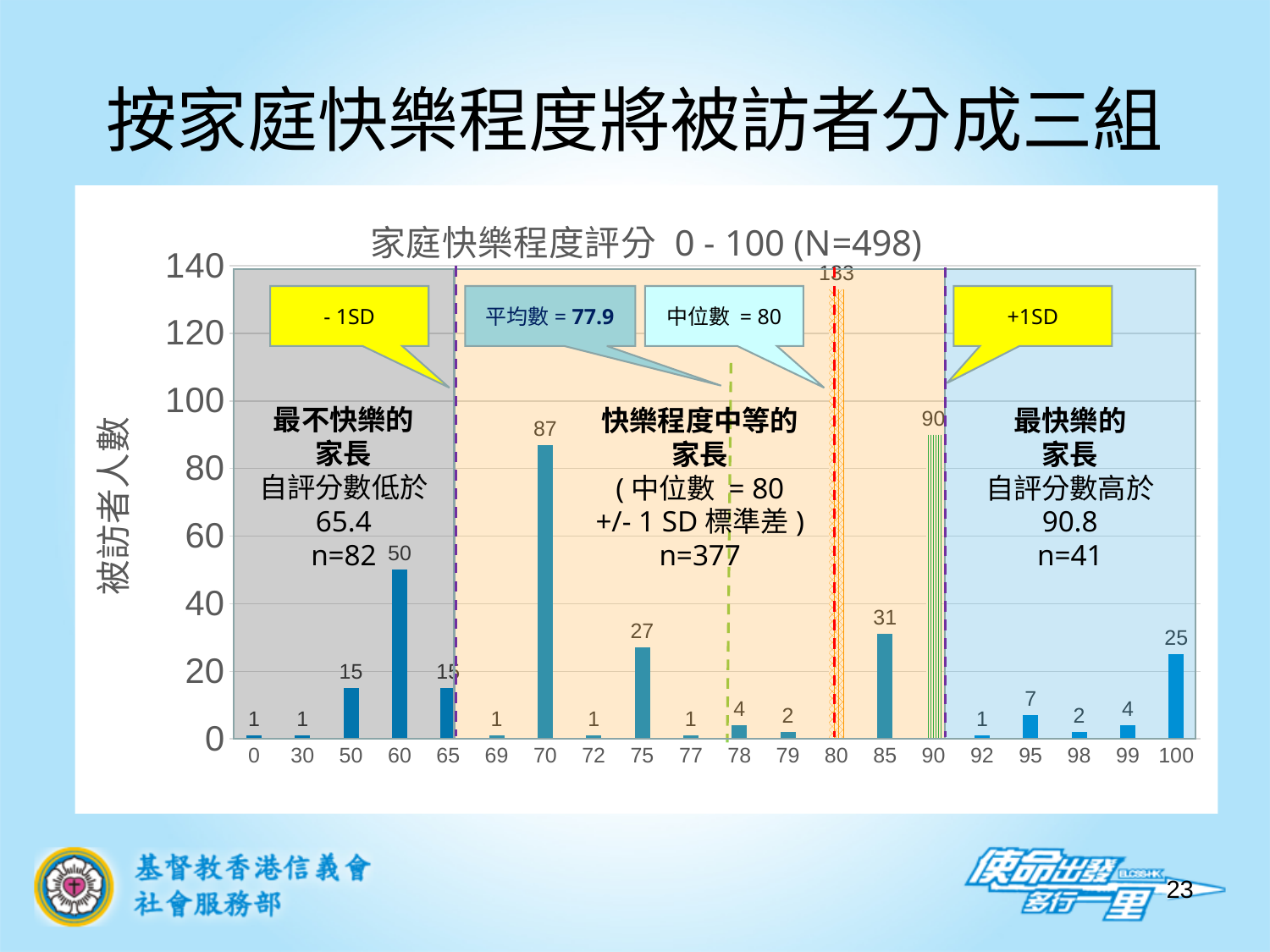
What is the number of respondents for the score of 95? 7 What is the number of respondents for the score of 100? 25 What is the difference between the number of respondents for score 70 and score 75? 60 Which score has the highest number of respondents? 80 Which score has more respondents, 90 or 85? 90 What is the number of respondents for the score of 60? 50 What is the number of respondents for the score of 85? 31 How many score categories are shown on the x axis? 20 Is the number of respondents for the score of 80 greater or less than 120? greater What kind of chart is shown on the slide? bar chart What is the mean (平均數) value shown in the callout on the chart? 77.9 What is the number of respondents (被訪者人數) for the score of 70? 87